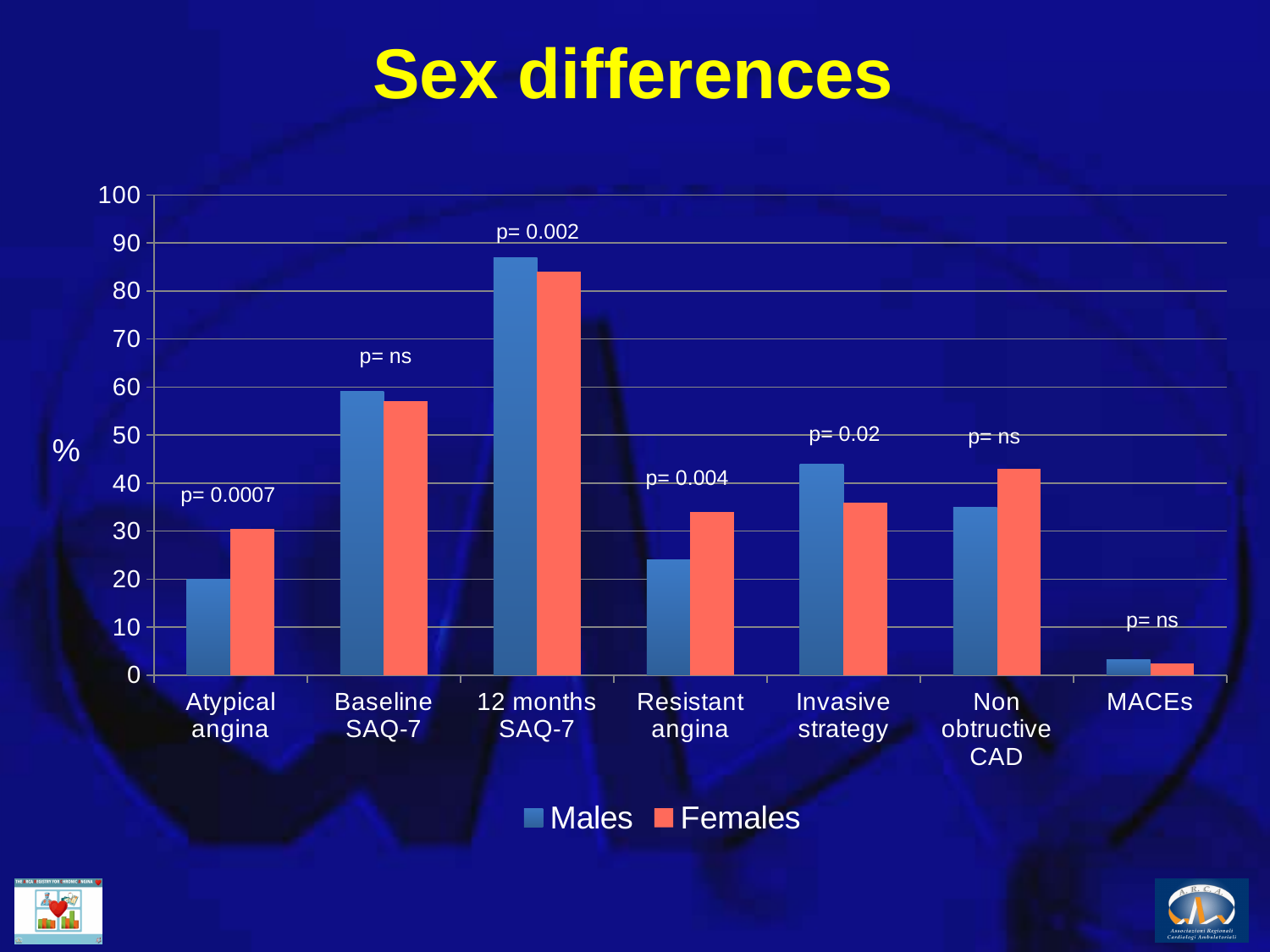
What p-value is printed above the Atypical angina bars? p= 0.0007 Which is larger for Resistant angina, Males or Females? Females What is the title of the slide? Sex differences Which is larger for Invasive strategy, Males or Females? Males Is the value for Males in Atypical angina greater or less than 30? less How many categories are shown along the x axis? 7 What kind of chart is shown on the slide? bar chart Is the value for Males in Invasive strategy greater or less than 40? greater Is the value for Females in 12 months SAQ-7 greater or less than 80? greater How many series does the legend list? 2 Which category has the highest value for Males? 12 months SAQ-7 Which category has the lowest value for Females? MACEs